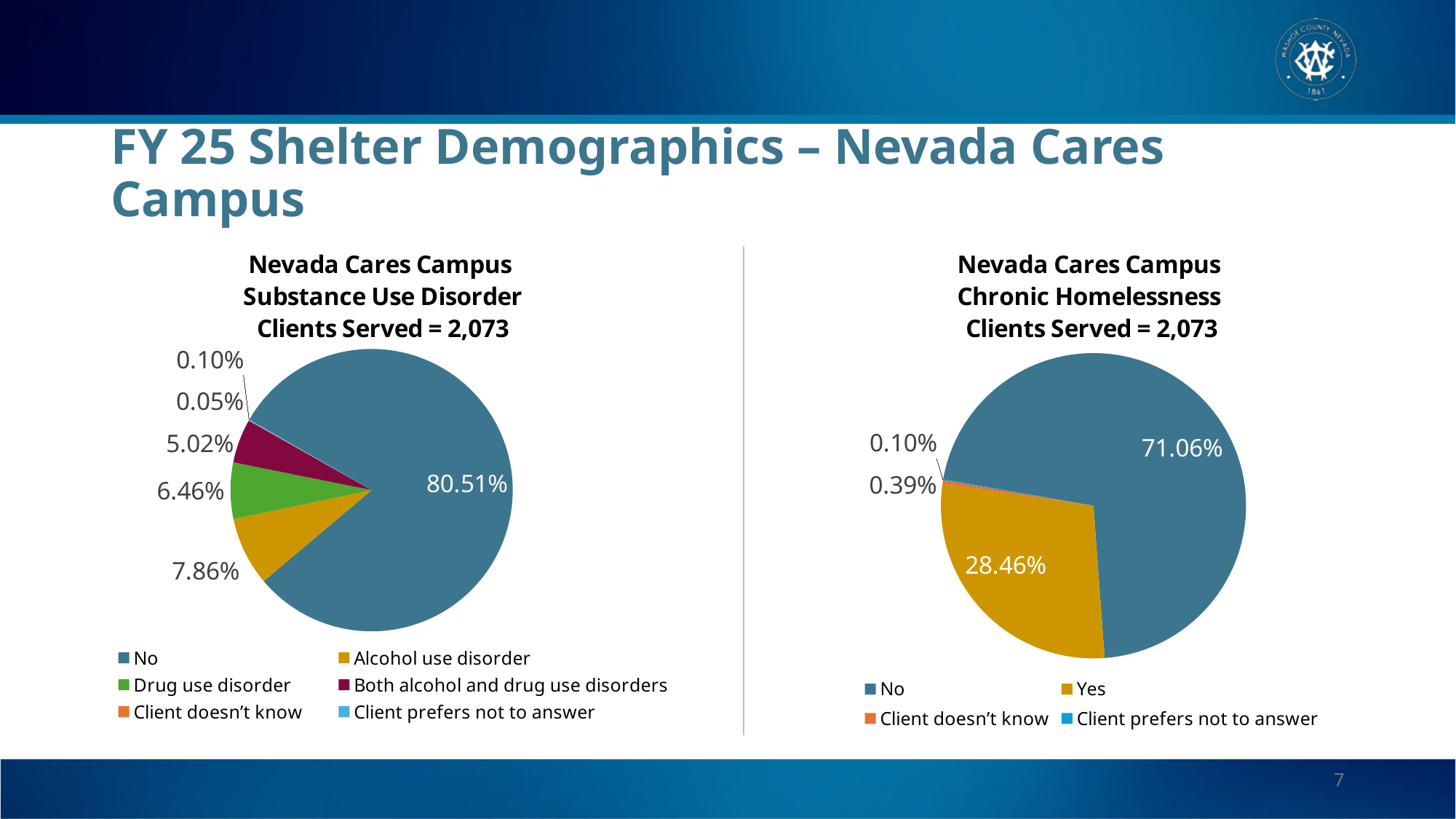
In the Substance Use Disorder chart, what share of clients have a drug use disorder? 6.46% In the Substance Use Disorder chart, what is the difference between the alcohol use disorder share and the drug use disorder share? 1.40% In the Substance Use Disorder chart, what share of clients have an alcohol use disorder? 7.86% In the Substance Use Disorder chart, what share of clients have both alcohol and drug use disorders? 5.02% How many clients were served according to the title of the Chronic Homelessness chart? 2,073 In the Substance Use Disorder chart, which category has the largest slice? No In the Chronic Homelessness chart, which is larger, the "No" slice or the "Yes" slice? No What kind of chart is the Nevada Cares Campus Substance Use Disorder chart? pie chart How many categories does the legend of the Substance Use Disorder chart list? 6